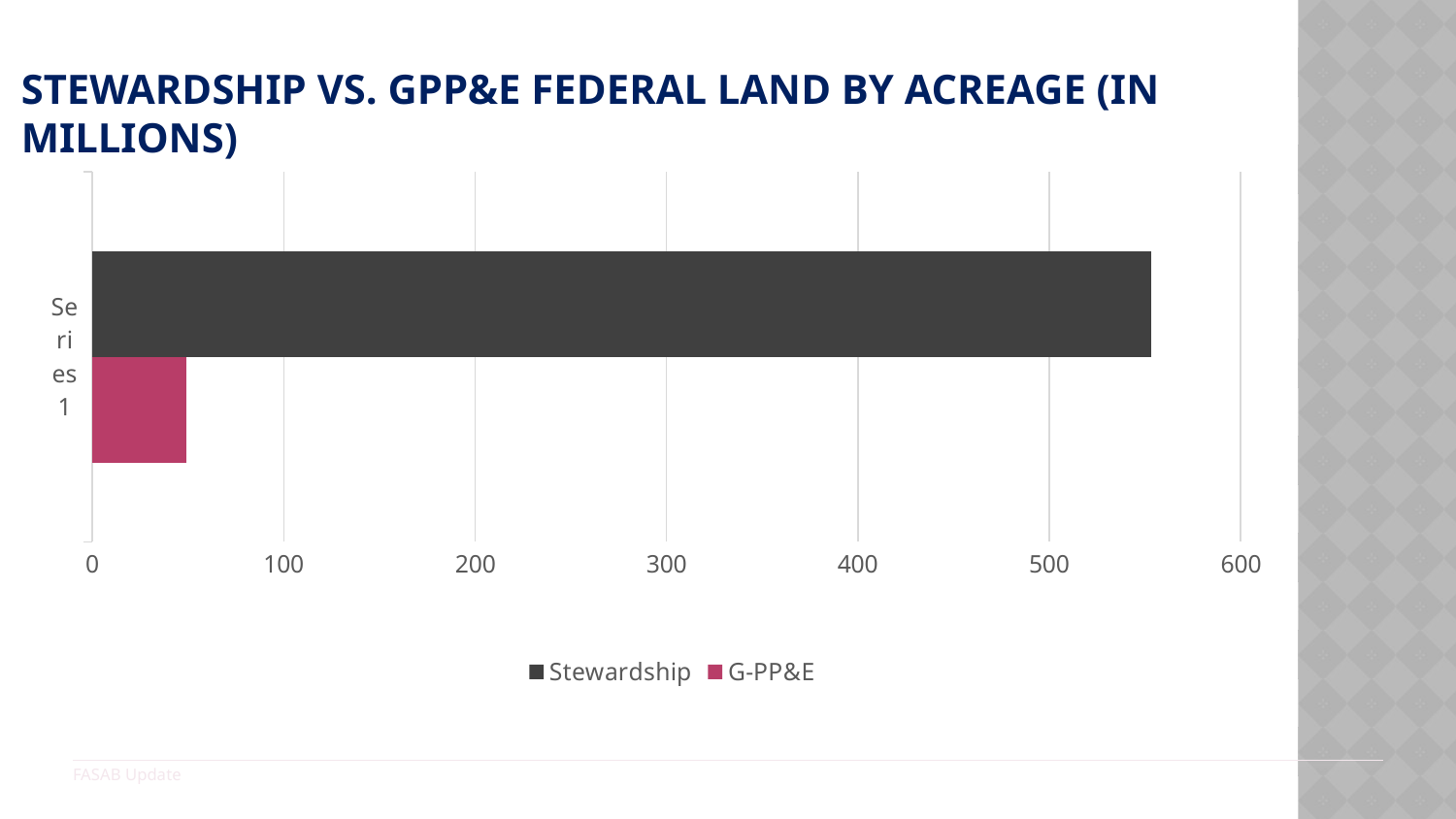
Which series is shown in the pink/magenta colour? G-PP&E How many series does the legend list? 2 What is the title of the chart? STEWARDSHIP VS. GPP&E FEDERAL LAND BY ACREAGE (IN MILLIONS) How many categories are plotted on the vertical axis? 1 Which series has the larger value, Stewardship or G-PP&E? Stewardship Is the value for Stewardship greater or less than 500? greater Which series has the lowest value? G-PP&E Which series has the highest value? Stewardship What kind of chart is shown on the slide? bar chart Is the value for G-PP&E greater or less than 100? less What is the highest value shown on the horizontal axis? 600 Is the value for Stewardship greater or less than 600? less